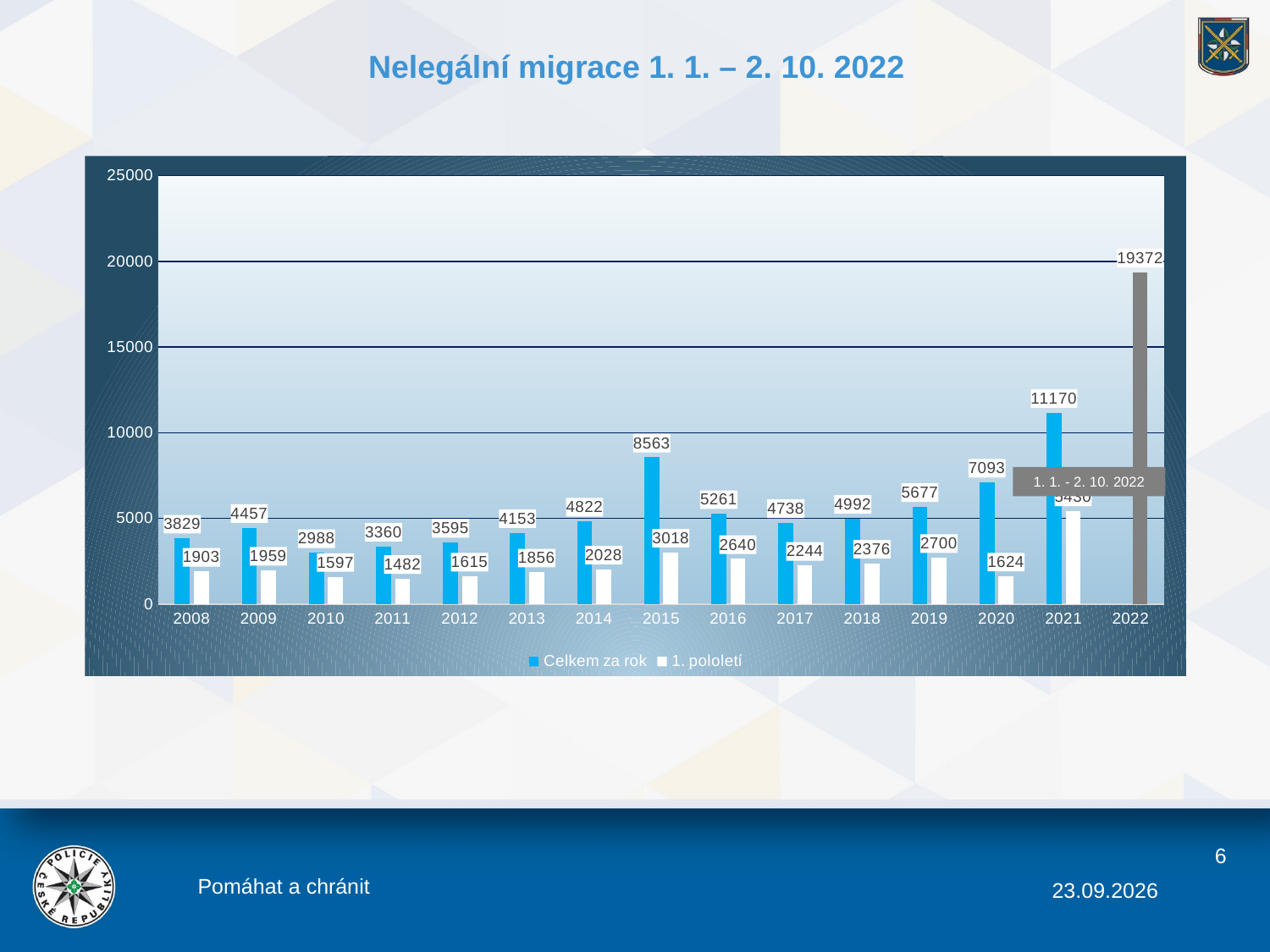
What is the difference between the 'Celkem za rok' values for 2021 and 2020? 4077 Is the value for 2022 greater or less than 15000? greater How many series does the legend list? 2 Which year has the lowest '1. pololetí' value? 2011 What kind of chart is shown on the slide? Bar chart Which year has the lowest 'Celkem za rok' value? 2010 Is the 'Celkem za rok' value for 2020 larger than the value for 2015? No What value is shown for the 2022 bar? 19372 What is the '1. pololetí' value for 2019? 2700 How many years are shown on the x axis? 15 What is the 'Celkem za rok' value for 2015? 8563 Which year has the highest 'Celkem za rok' value among 2008–2021? 2021